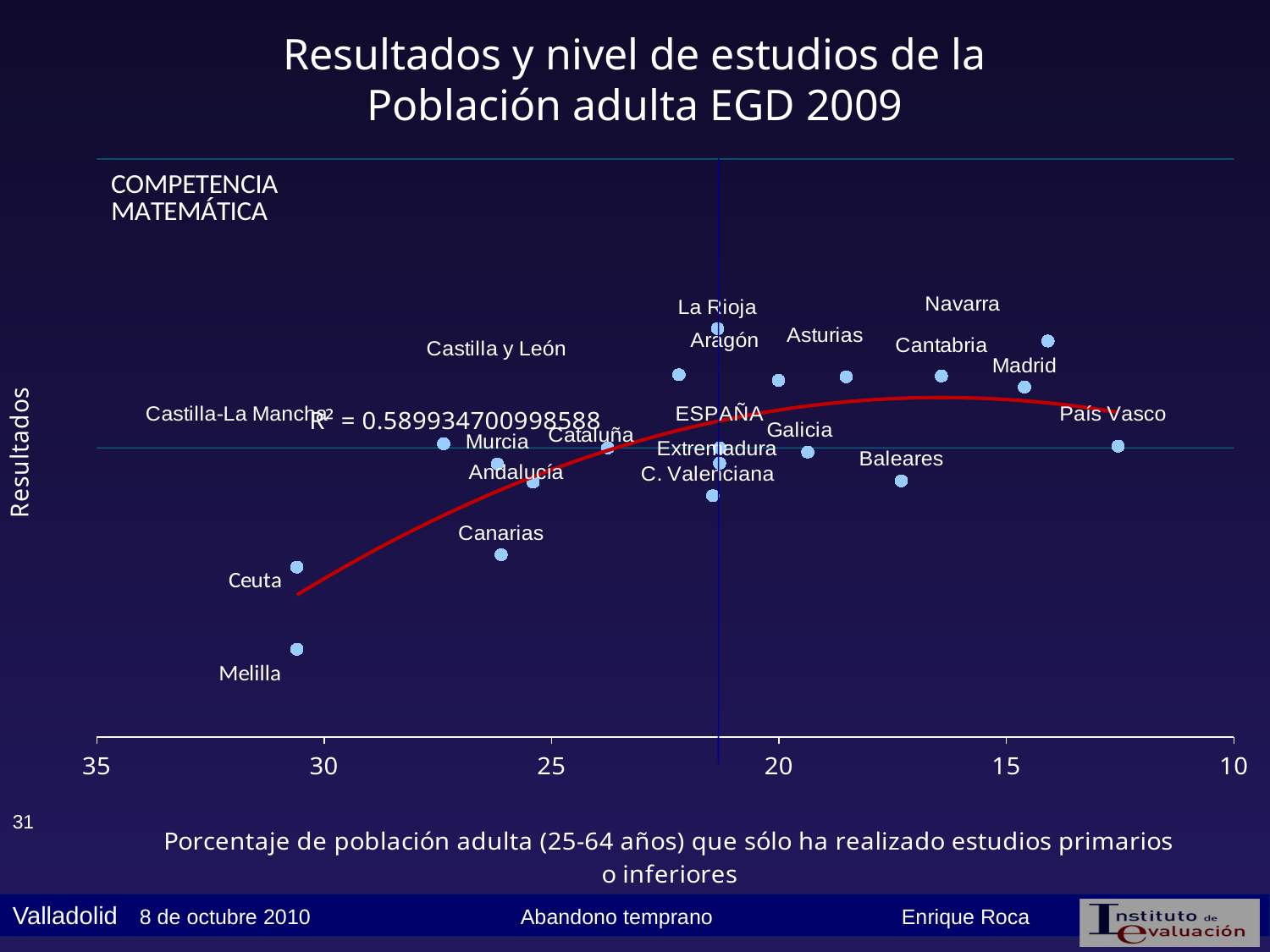
What R² value is printed on the chart? 0.589934700998588 What kind of chart is shown on the slide? scatter chart Which has the higher result, Melilla or Canarias? Canarias What colour is the fitted trend line on the chart? red Which has the higher result, Ceuta or Madrid? Madrid Is the x-axis value for Baleares greater or less than 20? less Is the x-axis value for País Vasco greater or less than 15? less What is the label of the vertical axis? Resultados Which region has the lowest percentage of adult population with only primary studies or less (smallest x value)? País Vasco Which region has the lowest result (lowest point on the chart)? Melilla Is the x-axis value for Castilla y León greater or less than 20? greater